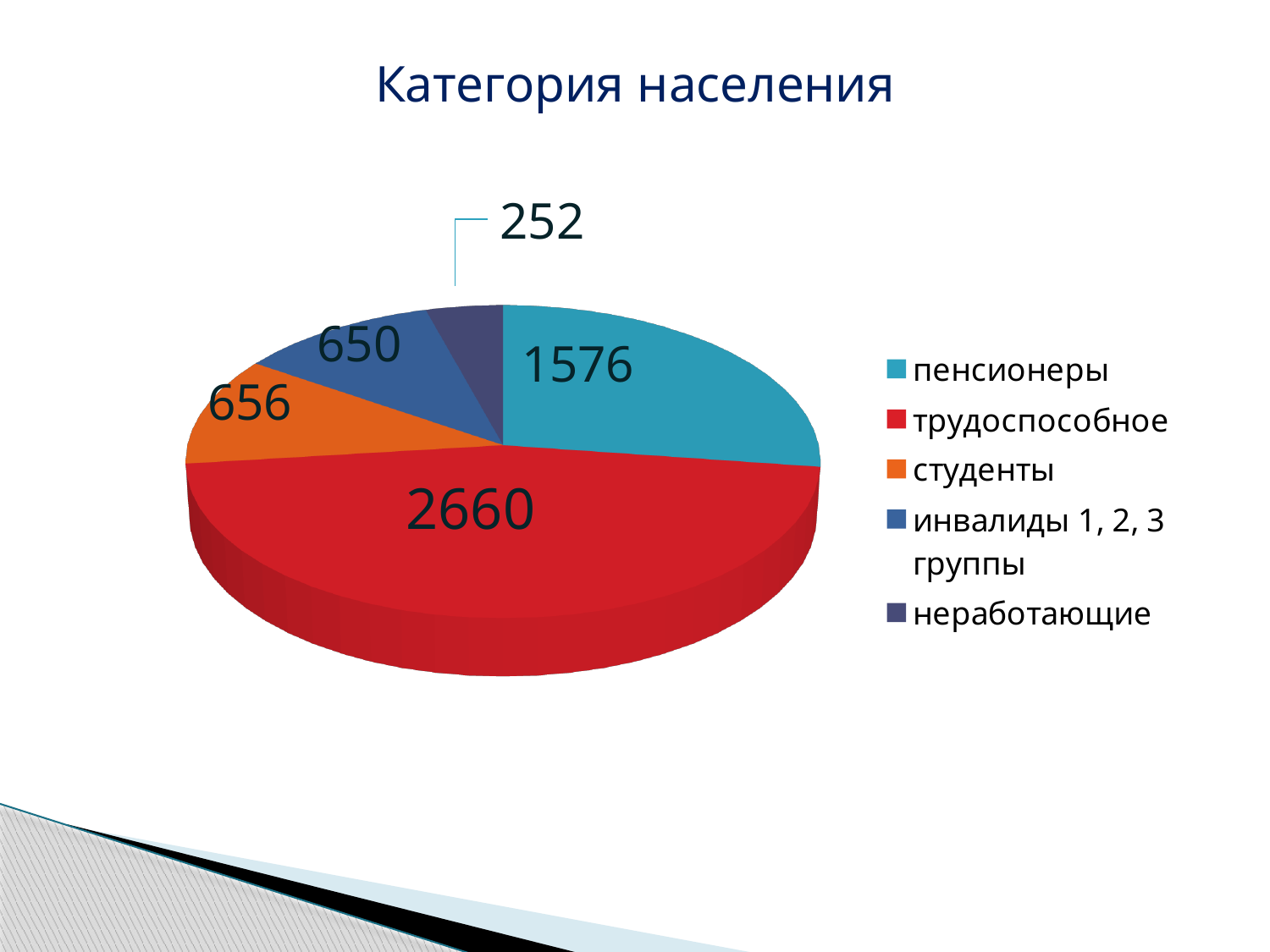
Which category has the smallest slice? неработающие Which is larger, the value for пенсионеры or the value for студенты? пенсионеры How many categories does the pie chart show? 5 Which category has the largest slice? трудоспособное What is the value for неработающие? 252 What is the value for студенты? 656 What is the value for трудоспособное? 2660 What kind of chart is shown on the slide? pie chart What is the value for инвалиды 1, 2, 3 группы? 650 What is the difference between the values for трудоспособное and пенсионеры? 1084 What is the title of the chart? Категория населения What is the value for пенсионеры? 1576